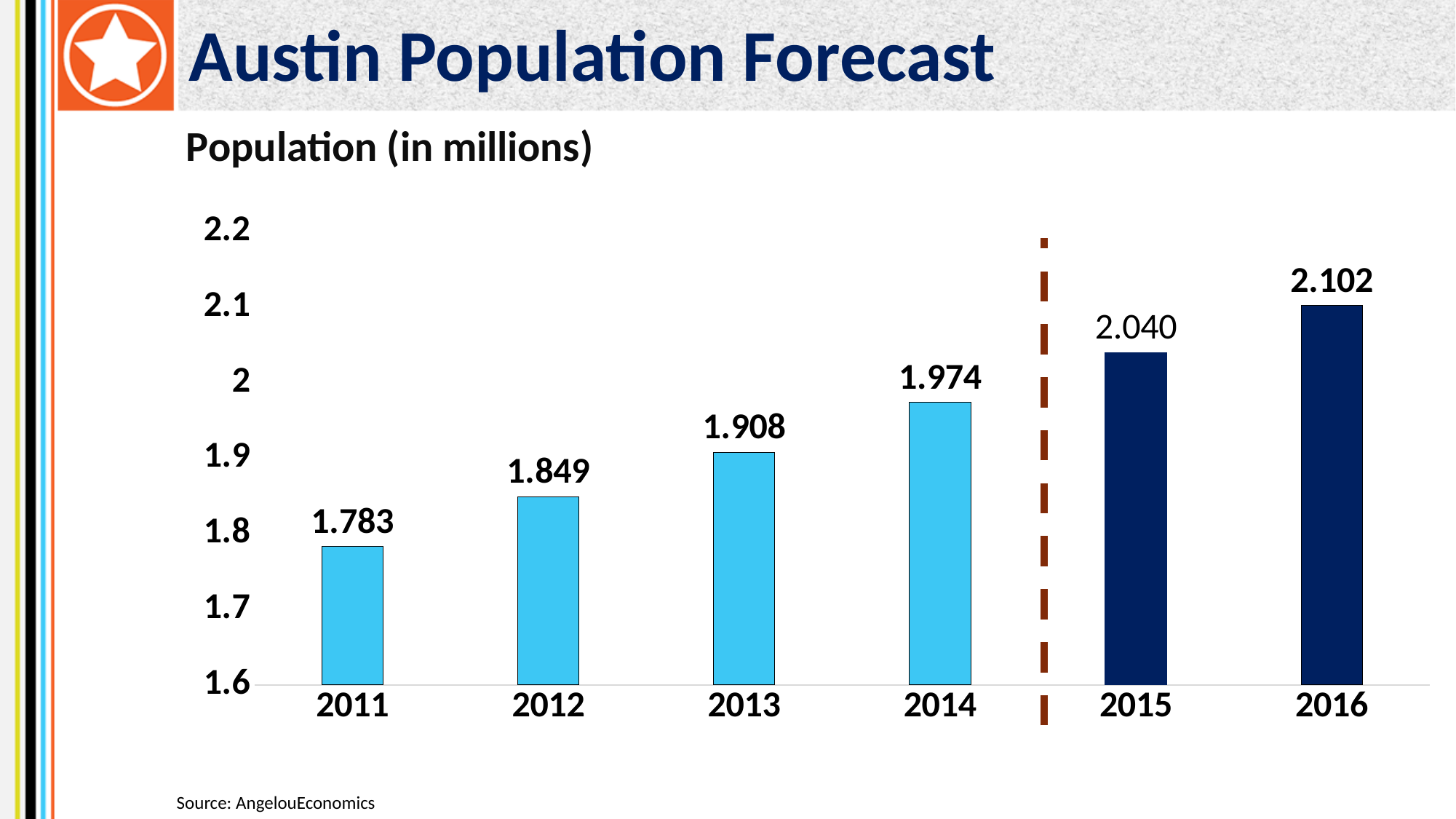
What is the population value shown for 2014? 1.974 What is the difference between the 2016 and 2011 population values? 0.319 How many years are shown on the x axis of the chart? 6 What kind of chart is shown on the slide? bar chart Which is larger, the value for 2013 or the value for 2012? 2013 Which year has the lowest population value on the chart? 2011 What is the forecast population value shown for 2016? 2.102 Do the population values rise or fall from 2011 to 2016? rise What is the difference between the 2015 and 2014 population values? 0.066 Is the value for 2015 greater or less than 2? greater Which year has the highest population value on the chart? 2016 What is the population value shown for 2011? 1.783